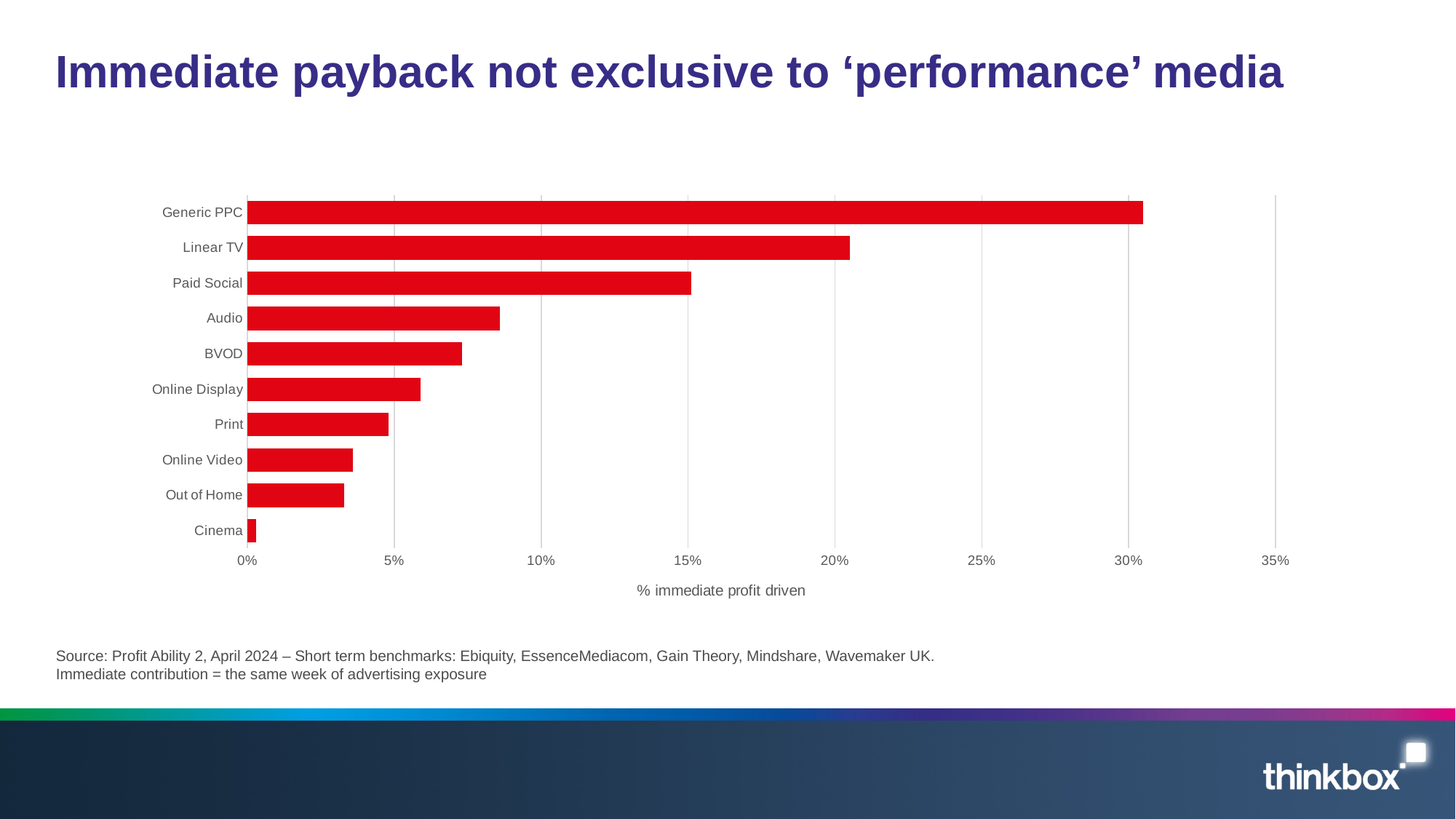
Which has a higher % immediate profit driven, BVOD or Online Display? BVOD How many media categories are plotted in the chart? 10 Is the value for Generic PPC greater or less than 30%? greater Is the value for Linear TV greater or less than 20%? greater What kind of chart is shown on the slide? Bar chart Is the value for Audio greater or less than 10%? less Which media category has the highest % immediate profit driven? Generic PPC Which media category has the lowest % immediate profit driven? Cinema Which has a higher % immediate profit driven, Linear TV or Paid Social? Linear TV What is the label on the horizontal axis of the chart? % immediate profit driven